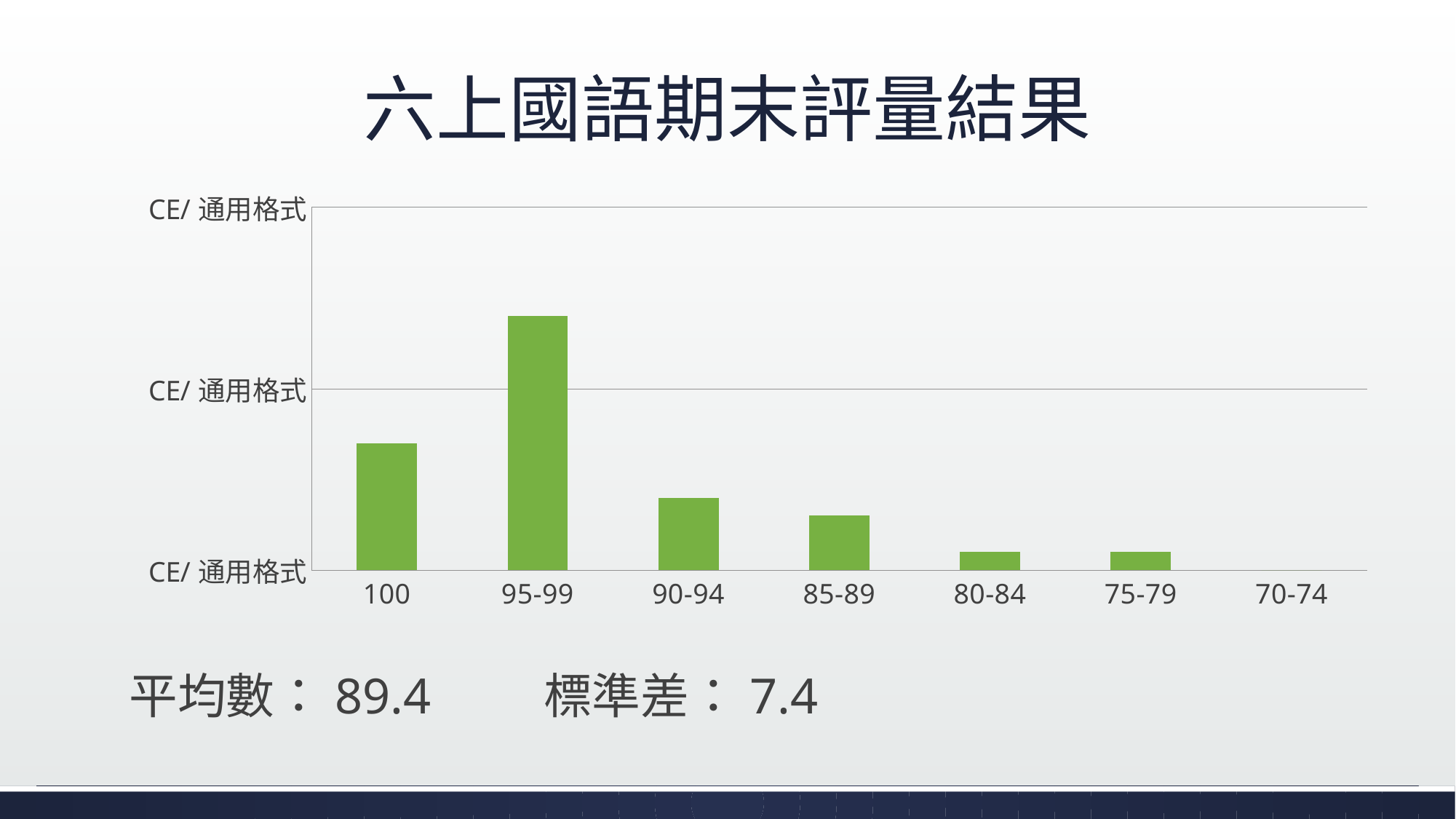
What colour are the bars in the chart? green What is the title of the chart on the slide? 六上國語期末評量結果 Which has the larger value, the 100 category or the 90-94 category? 100 How many score categories are shown on the x axis of the chart? 7 Which score category has the lowest value (no visible bar)? 70-74 Moving from the 95-99 category to the 70-74 category along the x axis, do the values rise or fall? fall Which has the larger value, the 95-99 category or the 100 category? 95-99 What kind of chart is shown on the slide? bar chart Which has the larger value, the 90-94 category or the 75-79 category? 90-94 Which score category has the highest bar? 95-99